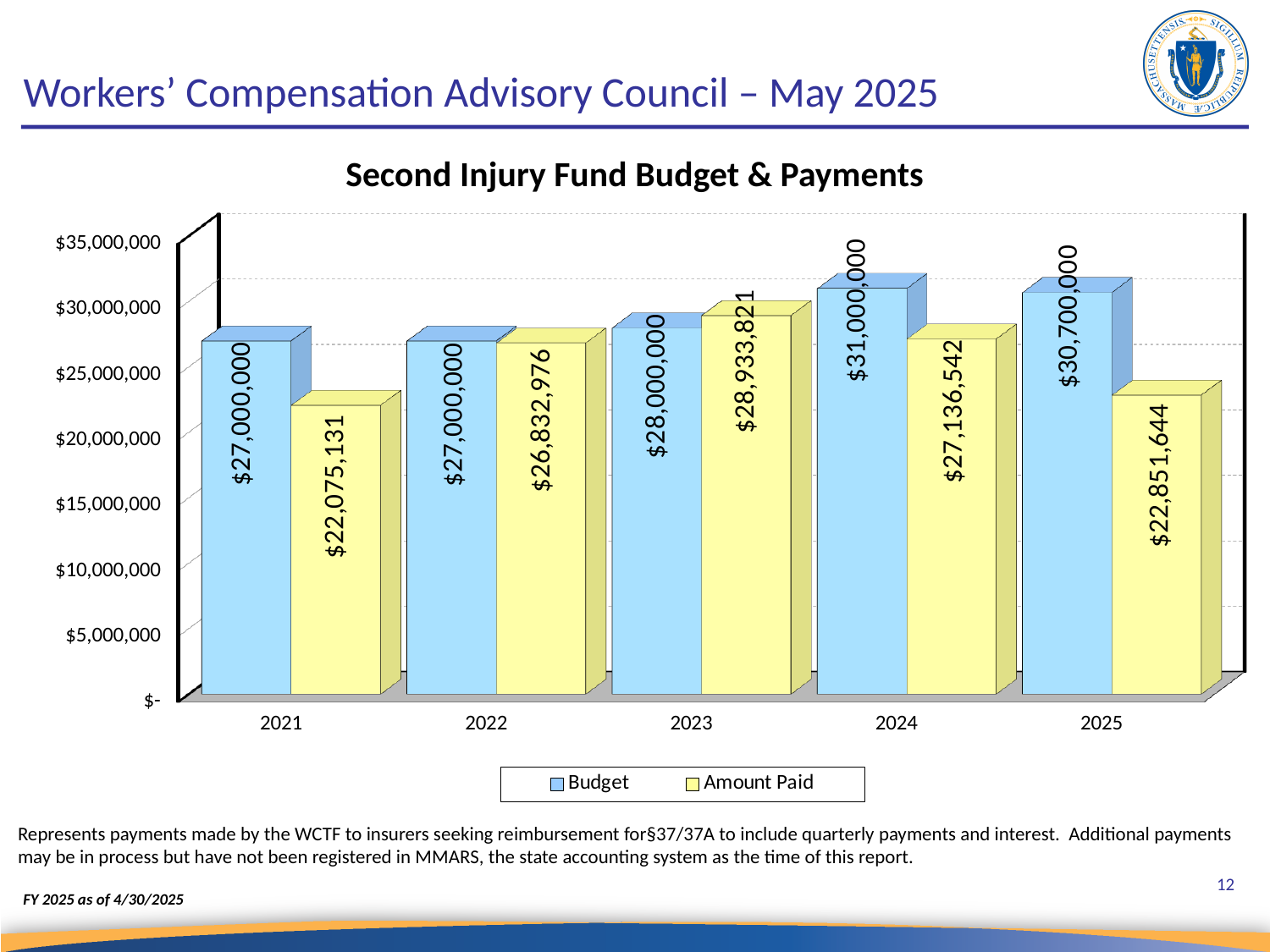
How many series does the legend list? 2 What is the Budget value for 2025? $30,700,000 What is the Amount Paid for 2021? $22,075,131 What is the Amount Paid for 2023? $28,933,821 Which year has the lowest Amount Paid? 2021 Which year has the highest Amount Paid? 2023 What type of chart is shown? Bar chart Which year has the highest Budget? 2024 What is the difference between the Budget and the Amount Paid in 2025? $7,848,356 What is the Budget value for 2024? $31,000,000 How many years are shown on the x axis? 5 In 2023, which is larger: the Budget or the Amount Paid? Amount Paid